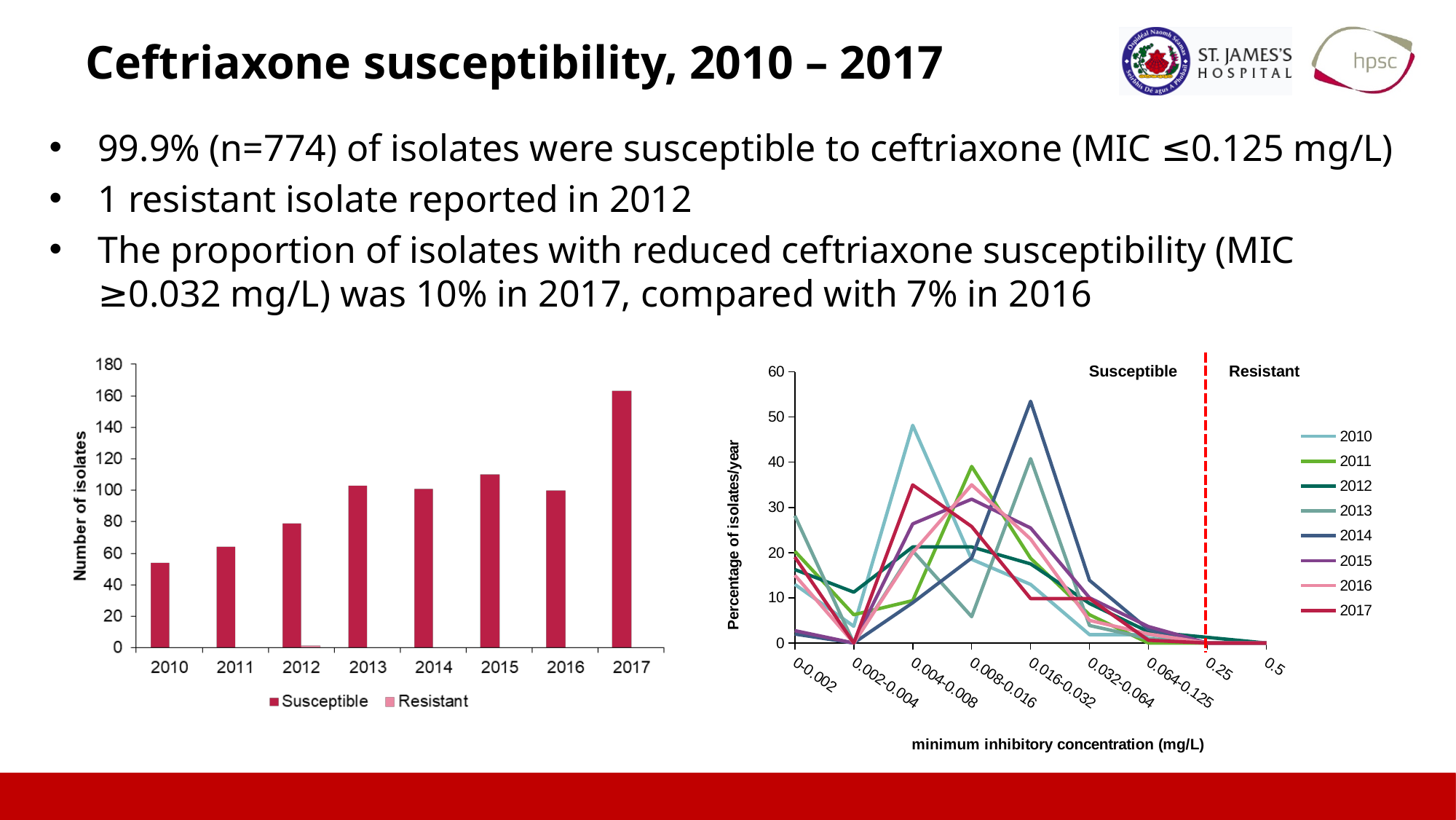
On the left chart, which year has the highest number of susceptible isolates? 2017 On the left chart, is the number of susceptible isolates in 2017 greater or less than 140? greater How many series does the legend of the left chart list? 2 On the left chart, which year has the lowest number of susceptible isolates? 2010 On the right chart, is the value for 2014 at 0.016-0.032 mg/L greater or less than 50? greater On the left chart, which year has more susceptible isolates, 2013 or 2012? 2013 How many series does the legend of the right chart list? 8 How many years are shown on the x axis of the left chart? 8 On the left chart, is the number of susceptible isolates in 2010 greater or less than 60? less What kind of chart is the left chart? Bar chart What is the x-axis title of the right chart? minimum inhibitory concentration (mg/L)